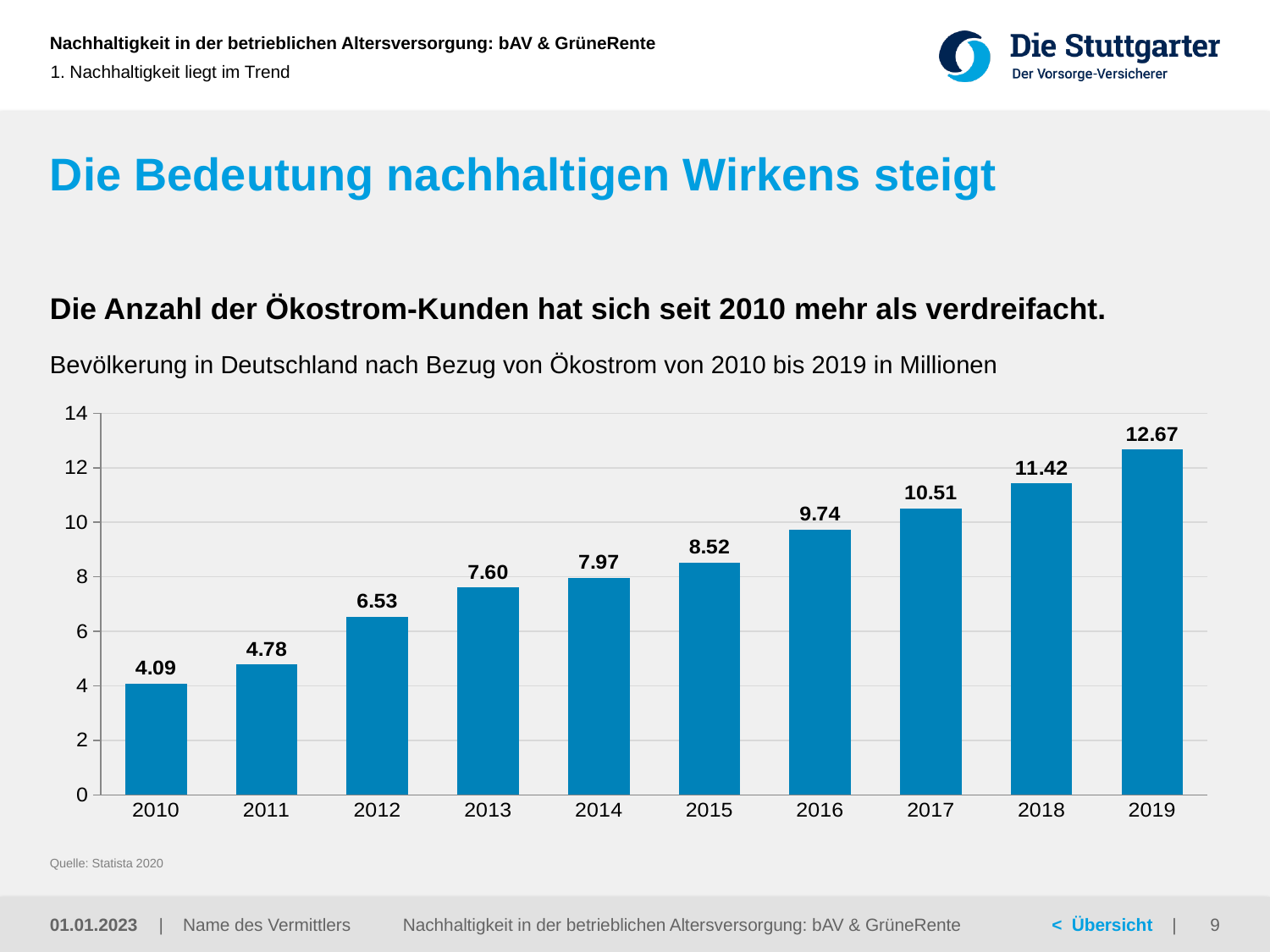
What is the difference between the values for 2019 and 2010? 8.58 What is the value for 2010? 4.09 What is the value for 2019? 12.67 Do the values rise or fall from 2010 to 2019? rise How many years are shown on the x axis? 10 Which year has the highest value? 2019 Which is larger, the value for 2013 or the value for 2017? 2017 What is the value for 2016? 9.74 What kind of chart is shown on the slide? bar chart What is the difference between the values for 2015 and 2014? 0.55 Which year has the lowest value? 2010 Is the value for 2012 greater or less than 6? greater